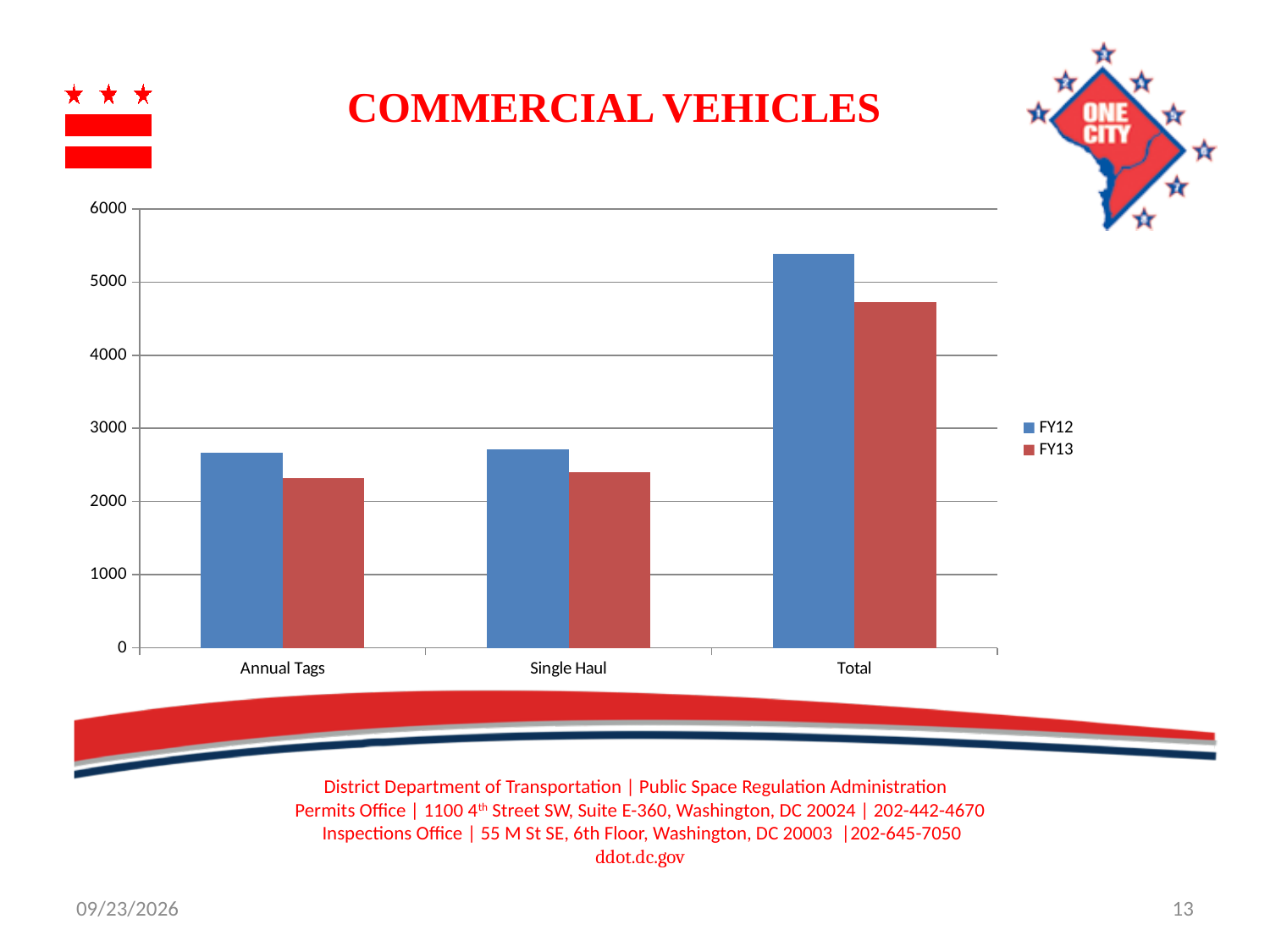
Which category has the highest FY13 value? Total Is the FY13 value for Annual Tags greater or less than 2000? greater For Annual Tags, which is larger, the FY12 value or the FY13 value? FY12 Which series is shown in blue in the legend? FY12 How many categories are shown on the x axis? 3 What is the title of the slide containing the chart? COMMERCIAL VEHICLES What kind of chart is shown on the slide? bar chart Is the FY13 value for Total greater or less than 5000? less Is the FY12 value for Total greater or less than 5000? greater How many series does the legend list? 2 Which category has the highest FY12 value? Total